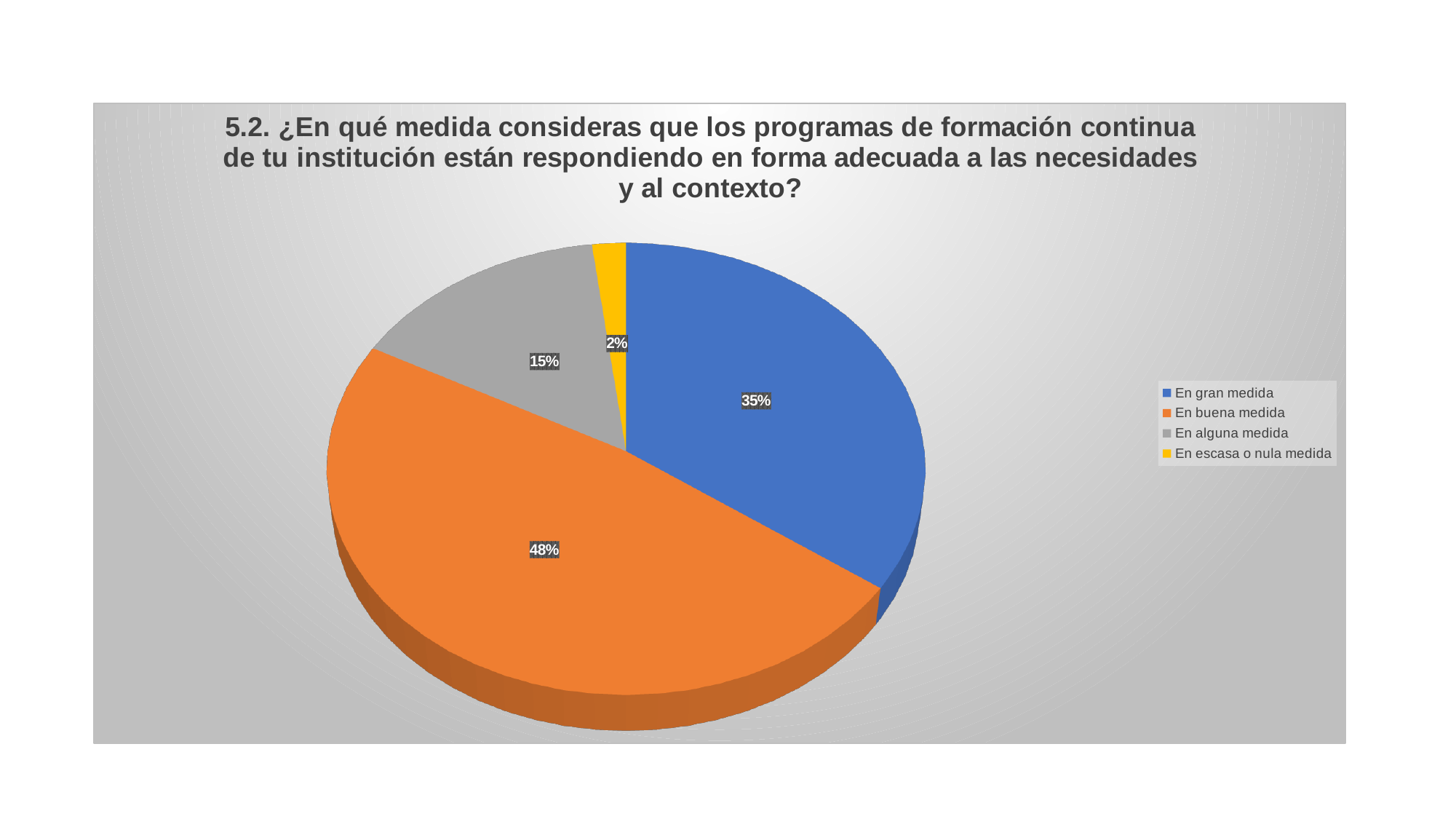
Which category has the smallest slice of the pie? En escasa o nula medida What colour is the slice for 'En escasa o nula medida'? Yellow Which category has the largest slice of the pie? En buena medida What share of the pie does 'En buena medida' represent? 48% Which is larger, the slice for 'En gran medida' or the slice for 'En alguna medida'? En gran medida What is the difference in percentage points between 'En buena medida' and 'En gran medida'? 13 What kind of chart is shown on the slide? Pie chart How many categories are shown in the pie chart? 4 What share of the pie does 'En alguna medida' represent? 15% What share of the pie does 'En escasa o nula medida' represent? 2% What is the difference in percentage points between 'En alguna medida' and 'En escasa o nula medida'? 13